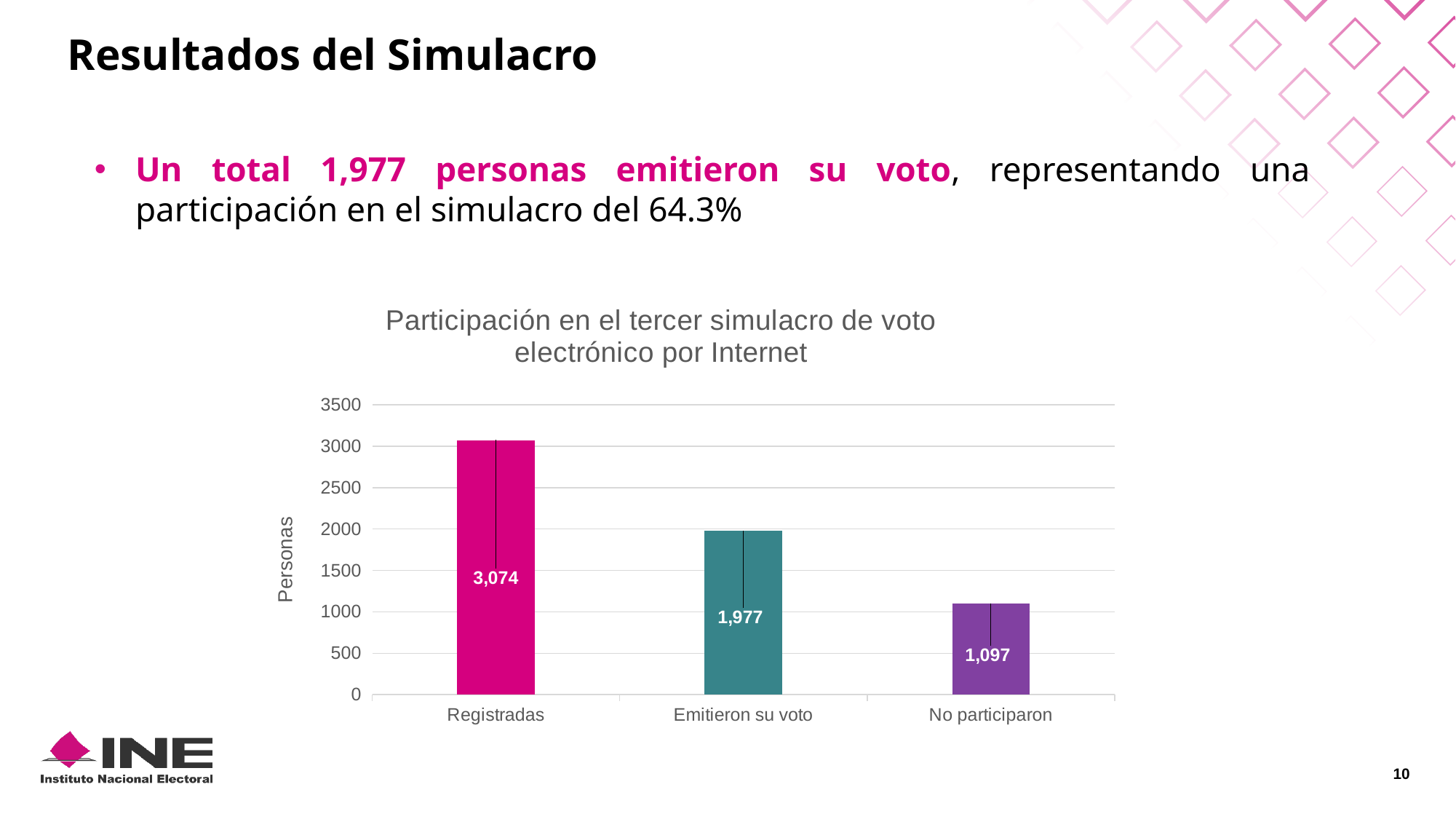
What is the title of the chart? Participación en el tercer simulacro de voto electrónico por Internet What is the value for Emitieron su voto? 1,977 What is the difference between Registradas and Emitieron su voto? 1,097 Which is larger, Emitieron su voto or No participaron? Emitieron su voto What is the value for Registradas? 3,074 How many categories are shown on the x axis? 3 What is the value for No participaron? 1,097 Is the value for Registradas greater or less than 3000? greater What is the difference between Emitieron su voto and No participaron? 880 What kind of chart is shown? bar chart Which category has the lowest value? No participaron Which category has the highest value? Registradas